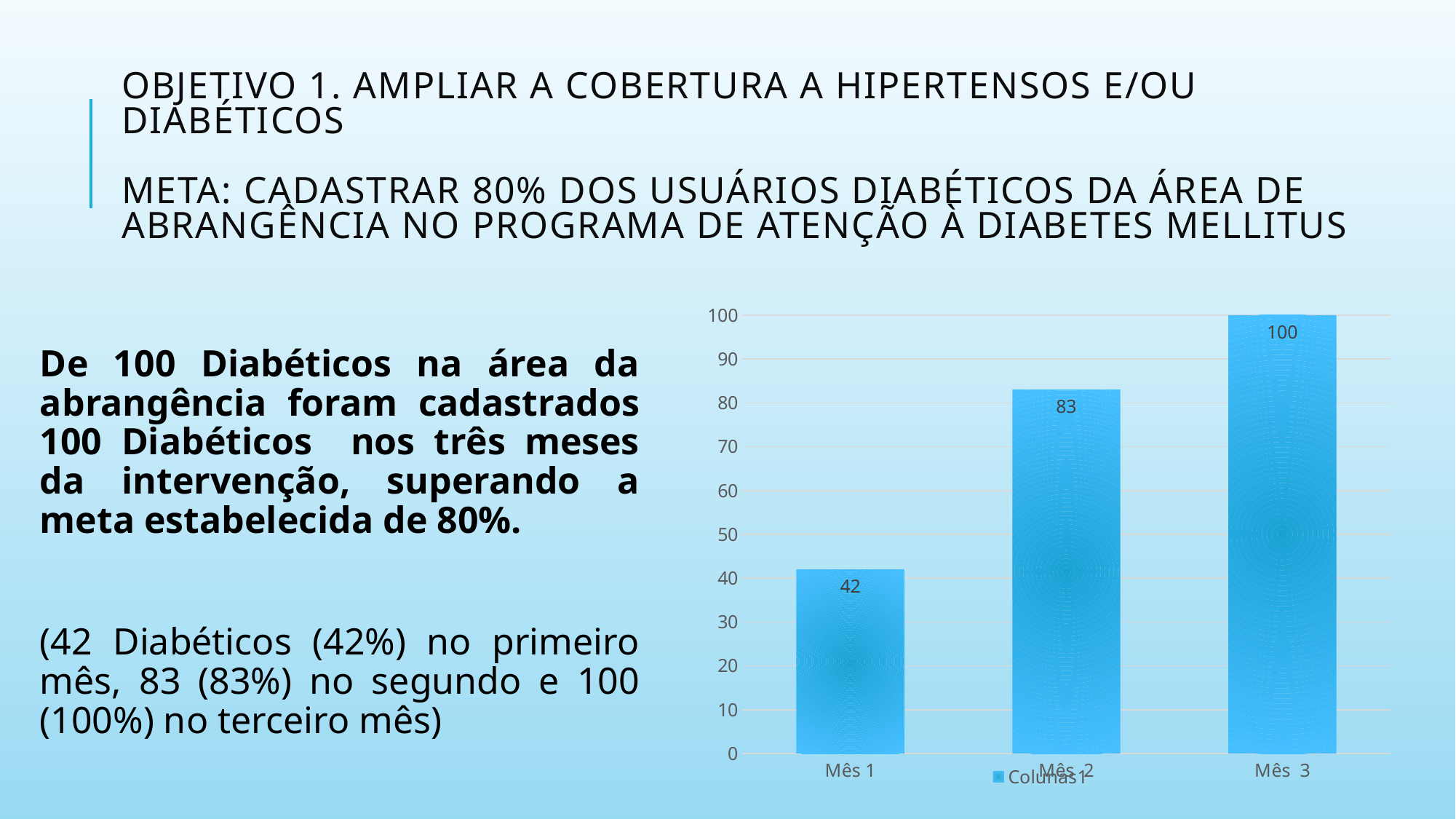
What is the value for Mês 2? 83 What is the value for Mês 3? 100 Is the value for Mês 2 greater or less than 80? greater Do the values rise or fall from Mês 1 to Mês 3? rise What is the value for Mês 1? 42 What is the difference between the values for Mês 2 and Mês 1? 41 What kind of chart is shown on the slide? bar chart How many bars are shown in the chart? 3 Which is larger, the value for Mês 1 or the value for Mês 2? Mês 2 What is the difference between the values for Mês 3 and Mês 1? 58 Which month has the highest value? Mês 3 Which month has the lowest value? Mês 1